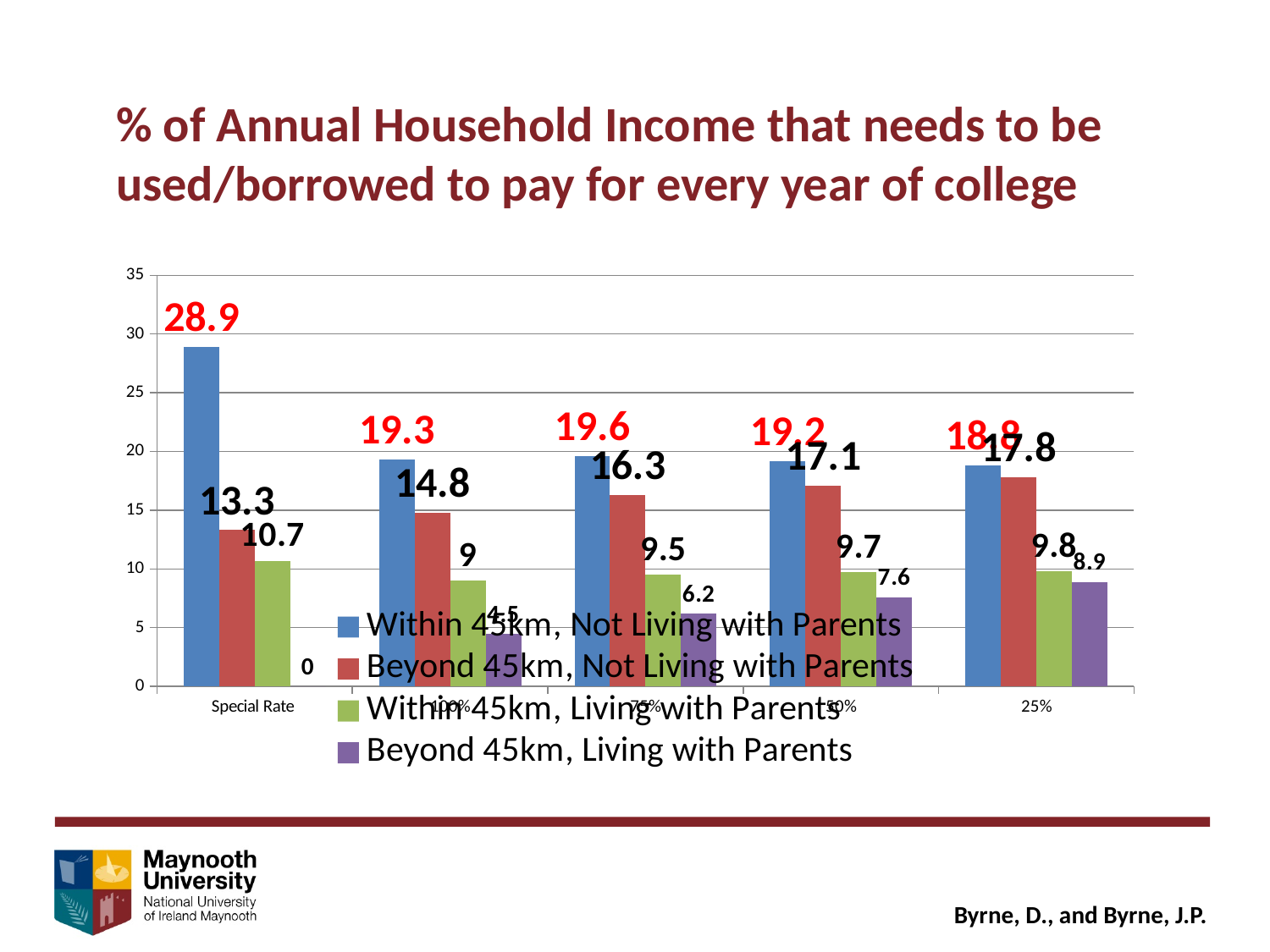
What is the value for Within 45km, Not Living with Parents in the Special Rate category? 28.9 What kind of chart is shown on the slide? Bar chart In the Special Rate category, what is the difference between Within 45km, Not Living with Parents and Beyond 45km, Not Living with Parents? 15.6 Does the Beyond 45km, Living with Parents series rise or fall from Special Rate to 25% along the x axis? Rises In which category is the Within 45km, Not Living with Parents series highest? Special Rate In which category is the Beyond 45km, Living with Parents series lowest? Special Rate In the 25% category, which is larger: Within 45km, Living with Parents or Beyond 45km, Living with Parents? Within 45km, Living with Parents How many categories are shown on the x axis? 5 How many series does the legend list? 4 What colour represents the Within 45km, Not Living with Parents series? Blue What is the value for Within 45km, Living with Parents in the 25% category? 9.8 What is the value for Beyond 45km, Not Living with Parents in the 25% category? 17.8